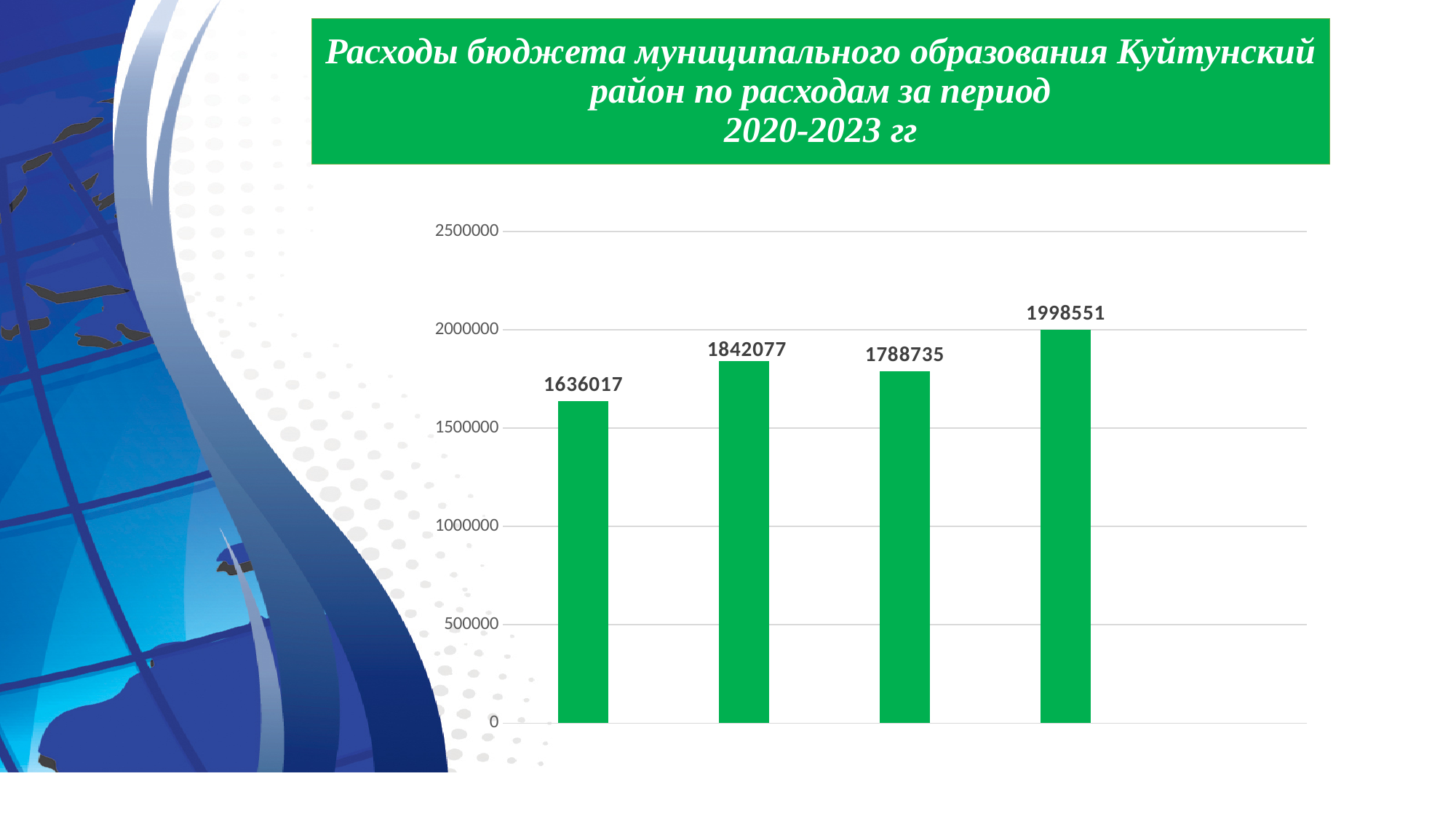
What kind of chart is shown on the slide? Bar chart What is the difference between the value of the rightmost bar and the value of the leftmost bar? 362534 How many bars are plotted in the chart? 4 What is the value shown on the second bar from the left? 1842077 Which bar has the highest value? The fourth (rightmost) bar, 1998551 What is the value shown on the third bar from the left? 1788735 What is the value shown on the fourth (rightmost) bar? 1998551 Which bar has the lowest value? The first (leftmost) bar, 1636017 Does the value rise or fall from the second bar to the third bar? fall Is the value of the leftmost bar greater or less than 1500000? greater Which is larger: the value of the second bar or the value of the third bar? The second bar (1842077) What is the value shown on the first (leftmost) bar? 1636017